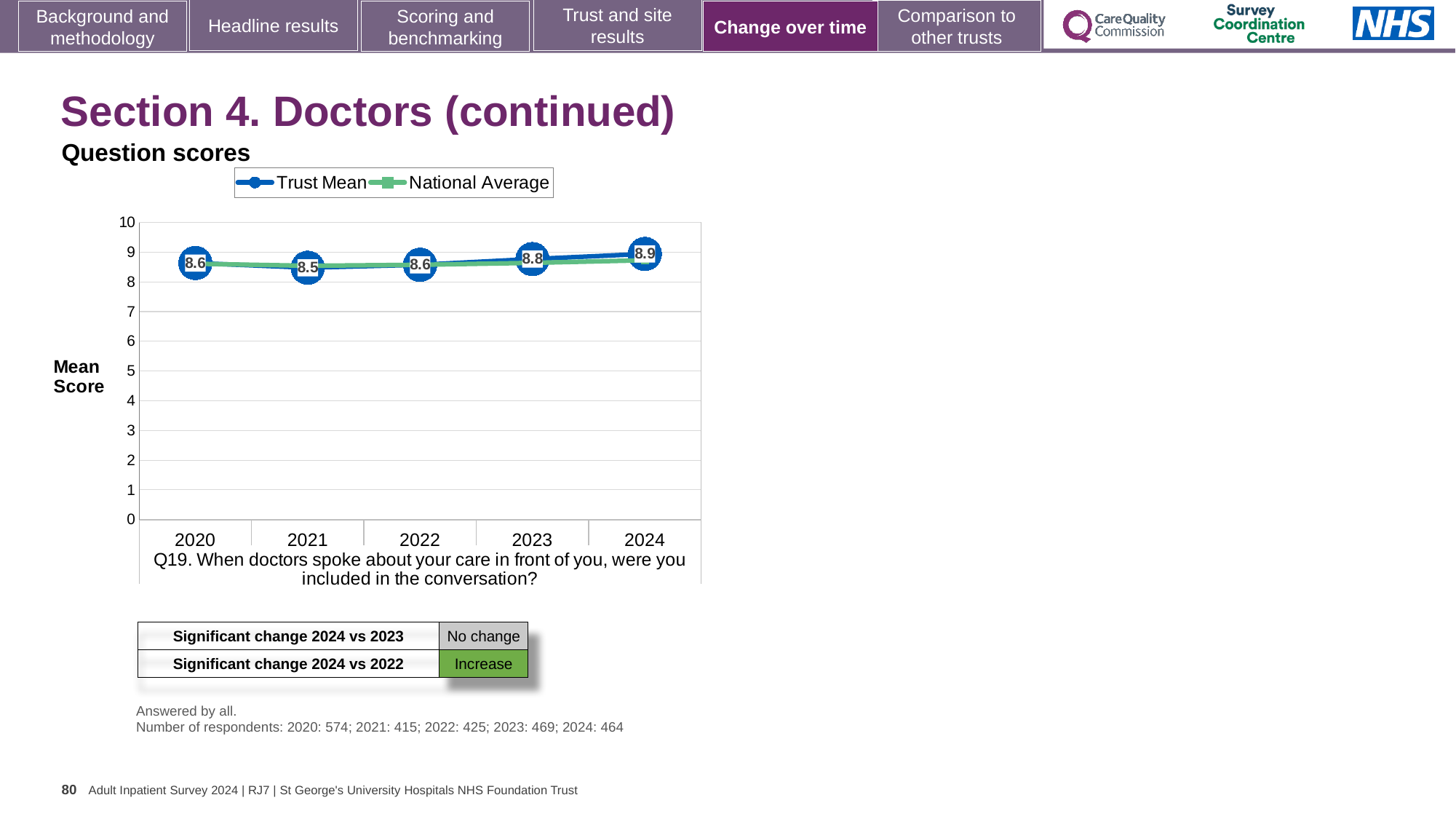
Is the National Average value for 2024 greater or less than 8? greater In which year is the Trust Mean score lowest? 2021 What is the Trust Mean score for 2023? 8.8 How many years are plotted on the x axis? 5 Does the Trust Mean score rise or fall from 2021 to 2024? Rise What is the Trust Mean score for 2021? 8.5 What is the difference between the Trust Mean score in 2024 and in 2021? 0.4 What kind of chart is shown on the slide? Line chart In which year is the Trust Mean score highest? 2024 Which is larger, the Trust Mean score for 2023 or for 2021? 2023 What is the Trust Mean score for 2024? 8.9 How many series does the legend list? 2